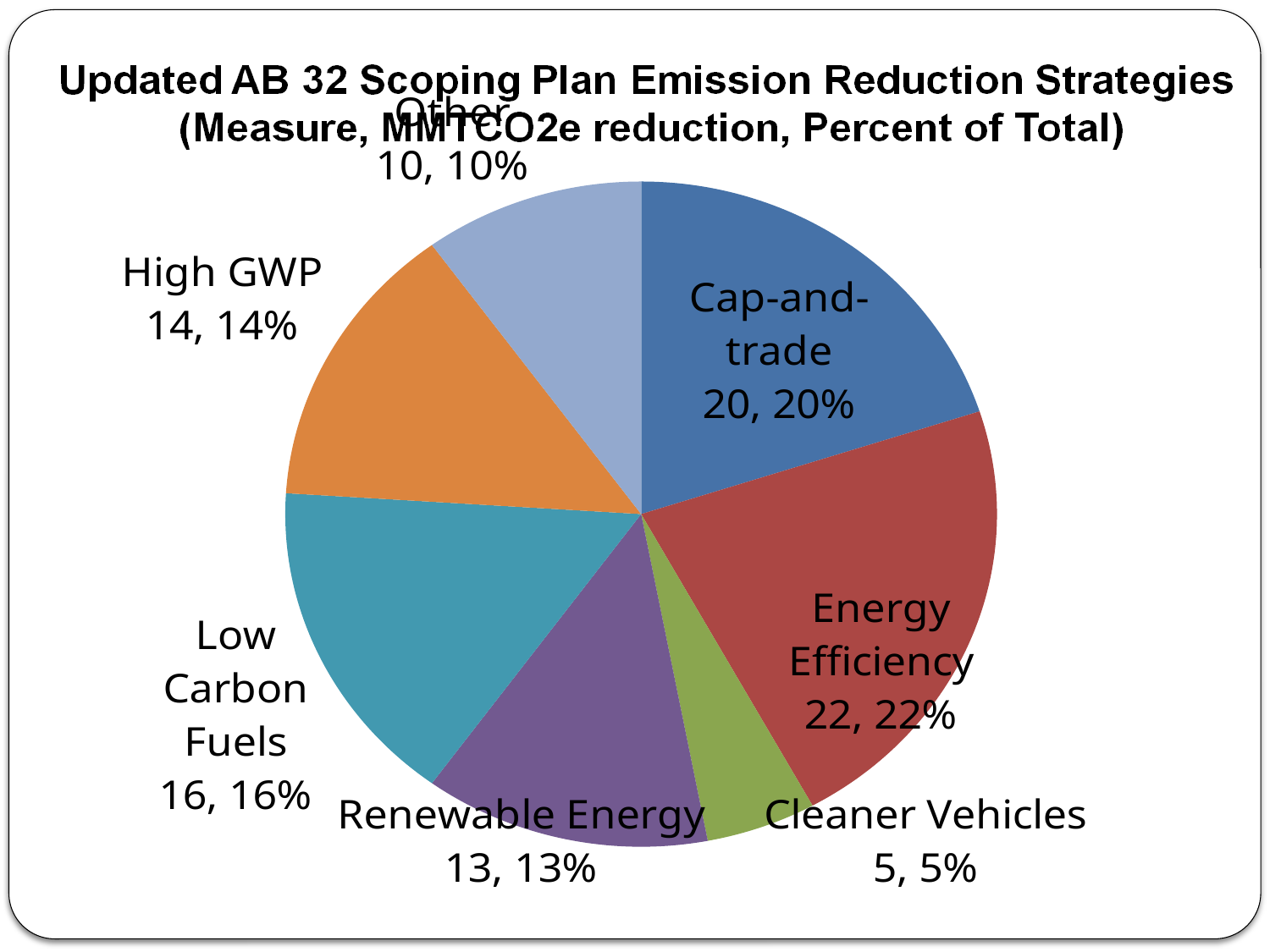
What percent of the total does Cap-and-trade account for? 20% What is the difference in MMTCO2e reduction between Low Carbon Fuels and Other? 6 How many measures (slices) are shown in the pie chart? 7 What is the MMTCO2e reduction value for Low Carbon Fuels? 16 Which measure has the smallest share of the pie? Cleaner Vehicles What is the MMTCO2e reduction value for Energy Efficiency? 22 What is the difference in MMTCO2e reduction between Energy Efficiency and Cleaner Vehicles? 17 Which is larger, the reduction for High GWP or for Renewable Energy? High GWP What is the title of the chart? Updated AB 32 Scoping Plan Emission Reduction Strategies (Measure, MMTCO2e reduction, Percent of Total) What kind of chart is shown on the slide? pie chart Which measure has the largest share of the pie? Energy Efficiency What percent of the total does Other account for? 10%